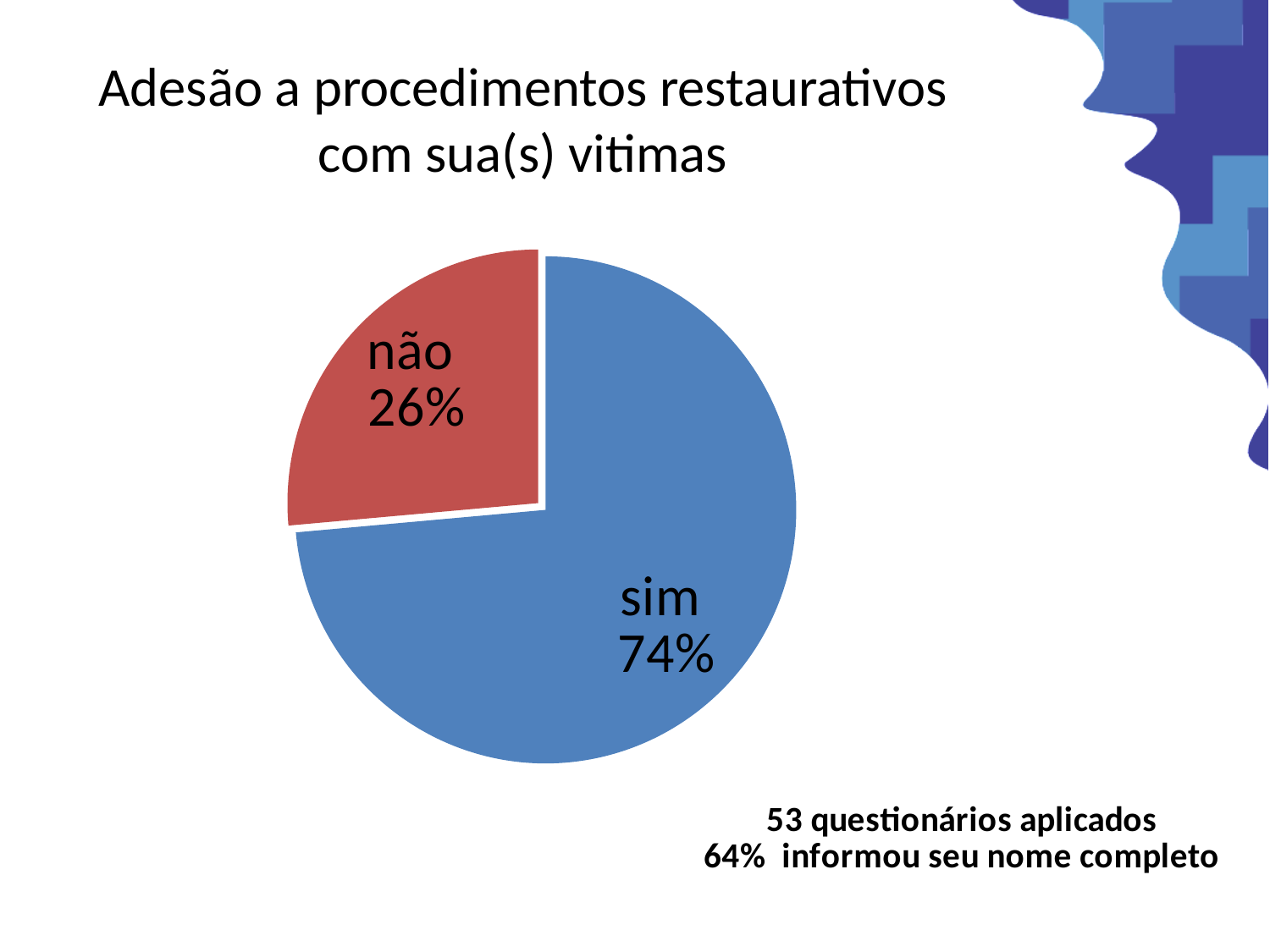
What is the difference in percentage points between the "sim" and "não" slices? 48 What kind of chart is shown on the slide? pie chart Which slice of the pie is the smallest? não What share of the pie does the "não" slice represent? 26% Is the share for "sim" greater or less than 50%? greater What percentage of the pie is labelled "não"? 26% Which slice of the pie is the largest? sim Which slice is larger, "sim" or "não"? sim How many slices does the pie chart have? 2 What percentage of the pie is labelled "sim"? 74% What colour is the "sim" slice? blue